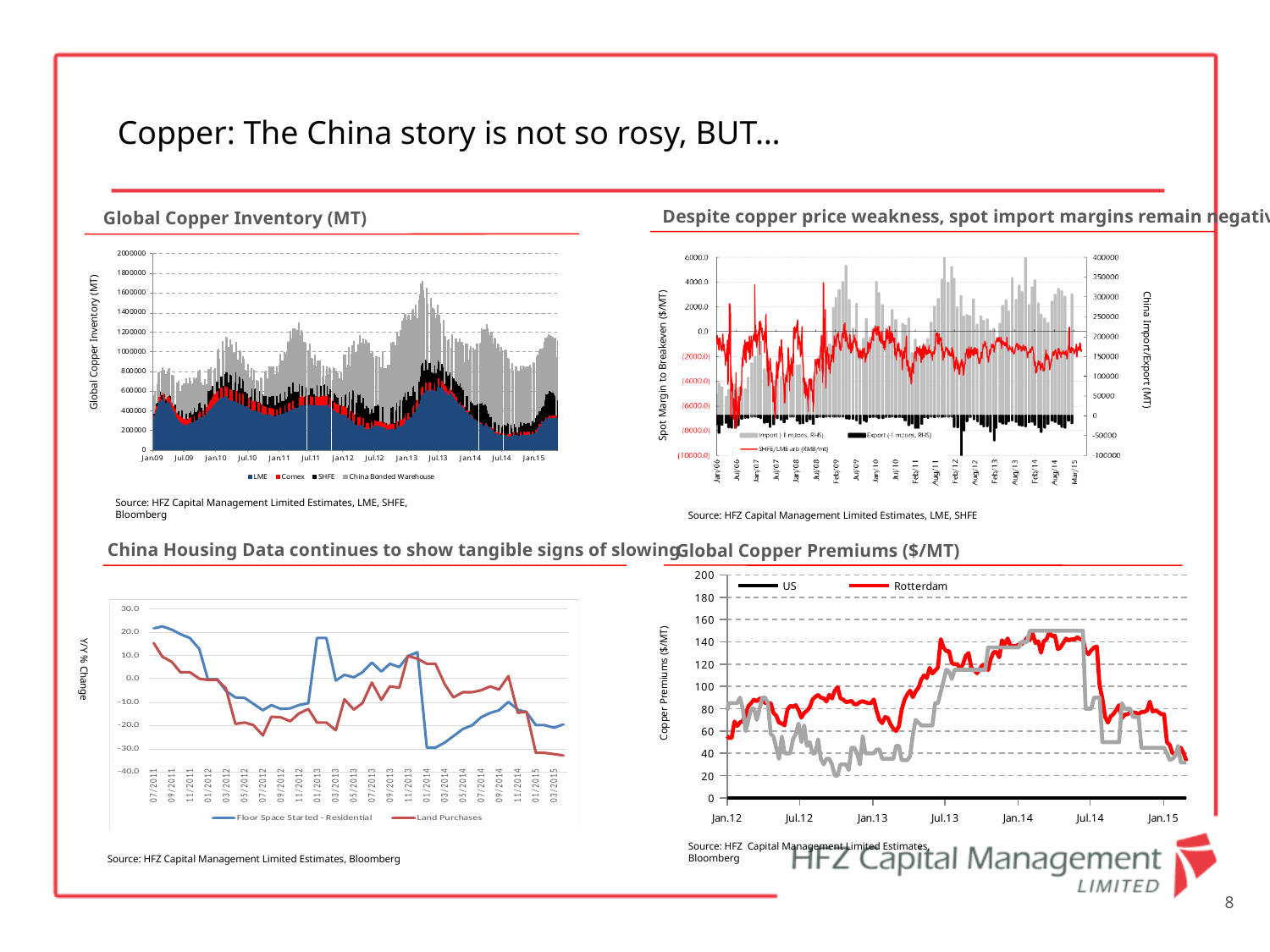
In the Global Copper Premiums ($/MT) chart, is the Rotterdam value at Jan.15 greater or less than 100? less How many series does the legend of the top-right chart (spot import margins) list? 3 In the Global Copper Premiums ($/MT) chart, is the US value at Jan.14 greater or less than 100? less In the China Housing Data chart, is the Land Purchases value at 03/2015 greater or less than -20? less What kind of chart is the Global Copper Inventory (MT) chart? Bar chart How many series does the legend of the China Housing Data chart list? 2 Which series are listed in the legend of the Global Copper Inventory (MT) chart? LME, Comex, SHFE, China Bonded Warehouse In the Global Copper Premiums ($/MT) chart, which series is higher at Jan.13, US or Rotterdam? Rotterdam How many series does the legend of the Global Copper Premiums ($/MT) chart list? 2 What kind of chart is the Global Copper Premiums ($/MT) chart? Line chart In the Global Copper Premiums ($/MT) chart, does the Rotterdam series rise or fall between Jul.14 and Jan.15? Fall